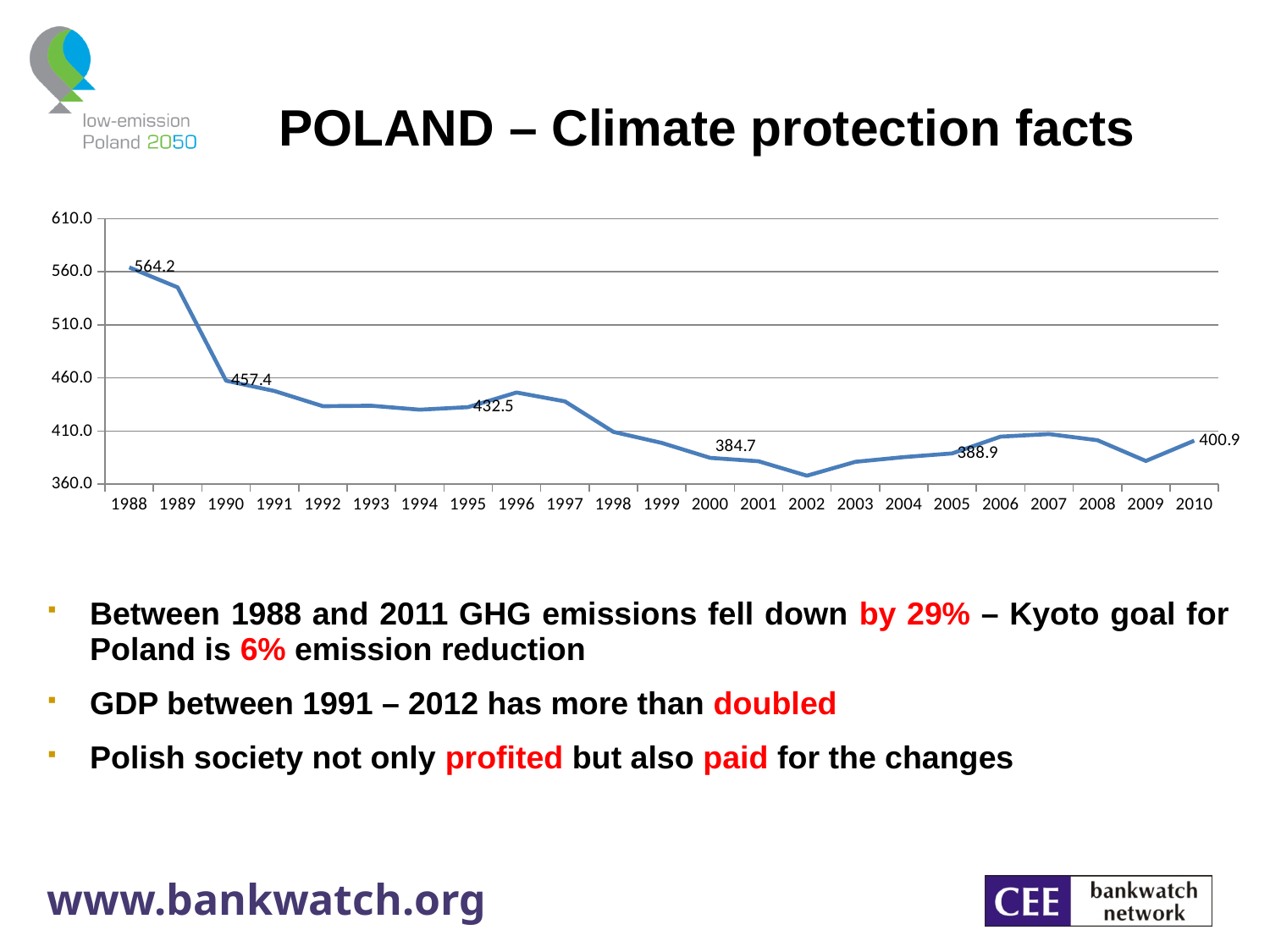
Which year has the highest value? 1988 Is the value for 1989 greater or less than 510.0? greater Which is larger, the value for 2000 or the value for 2005? 2005 What is the value for 2010? 400.9 What is the value for 1988? 564.2 What is the difference between the values for 1988 and 2010? 163.3 What is the value for 1990? 457.4 What is the value for 2000? 384.7 What is the value for 1995? 432.5 Which year has the lowest value? 2002 How many years are plotted on the x axis? 23 What kind of chart is shown on the slide? line chart